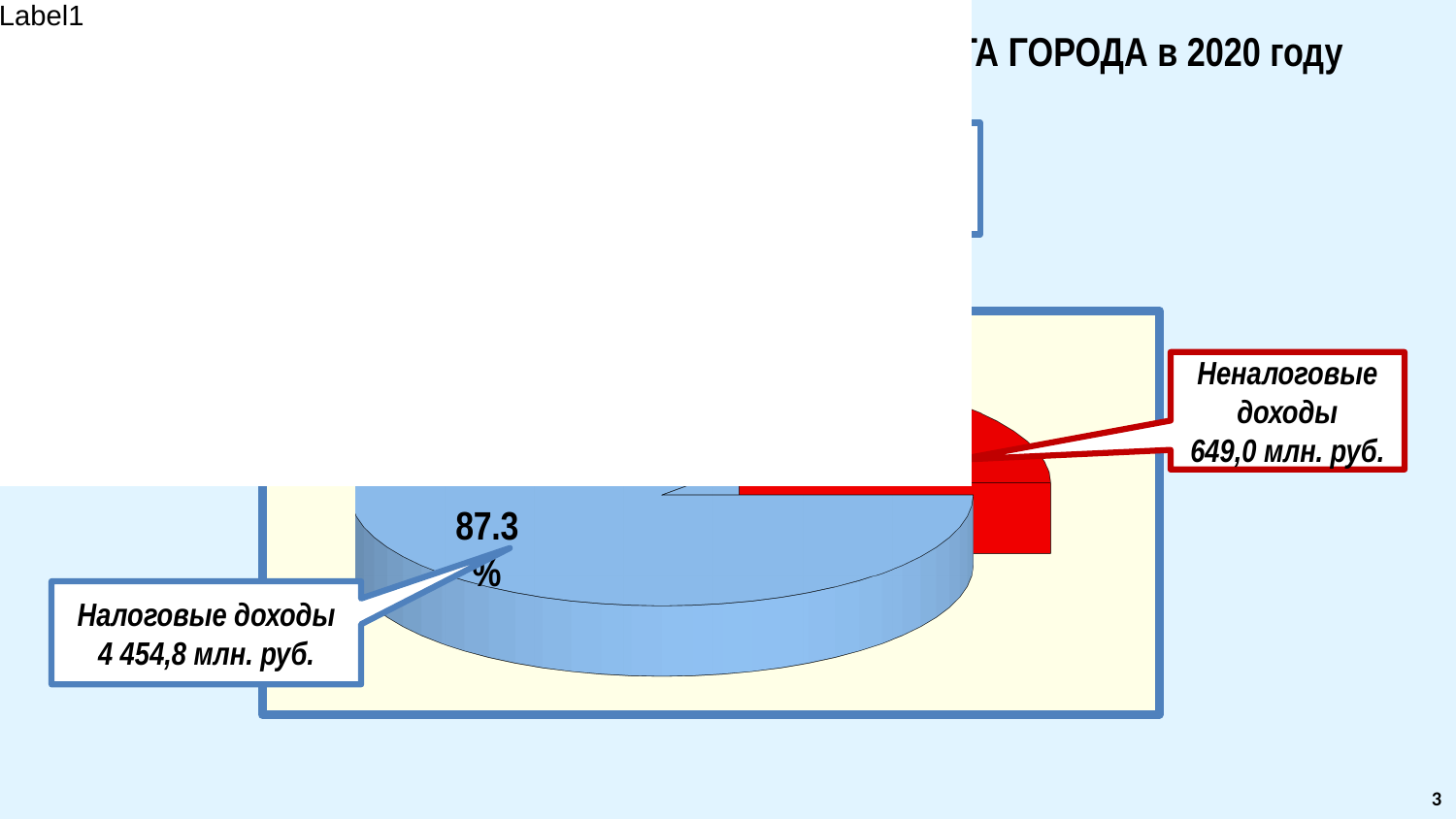
What is the difference between Налоговые доходы and Неналоговые доходы in млн. руб.? 3 805,8 млн. руб. What value is given for Налоговые доходы in the callout? 4 454,8 млн. руб. Which of the two labelled categories has the smaller value? Неналоговые доходы Which is larger, Налоговые доходы or Неналоговые доходы? Налоговые доходы What kind of chart is shown on the slide? Pie chart What colour is the Налоговые доходы slice? Blue What colour is the Неналоговые доходы slice? Red What percentage share is printed on the Налоговые доходы slice? 87.3% What value is given for Неналоговые доходы in the callout? 649,0 млн. руб. Which category has the largest slice of the pie? Налоговые доходы